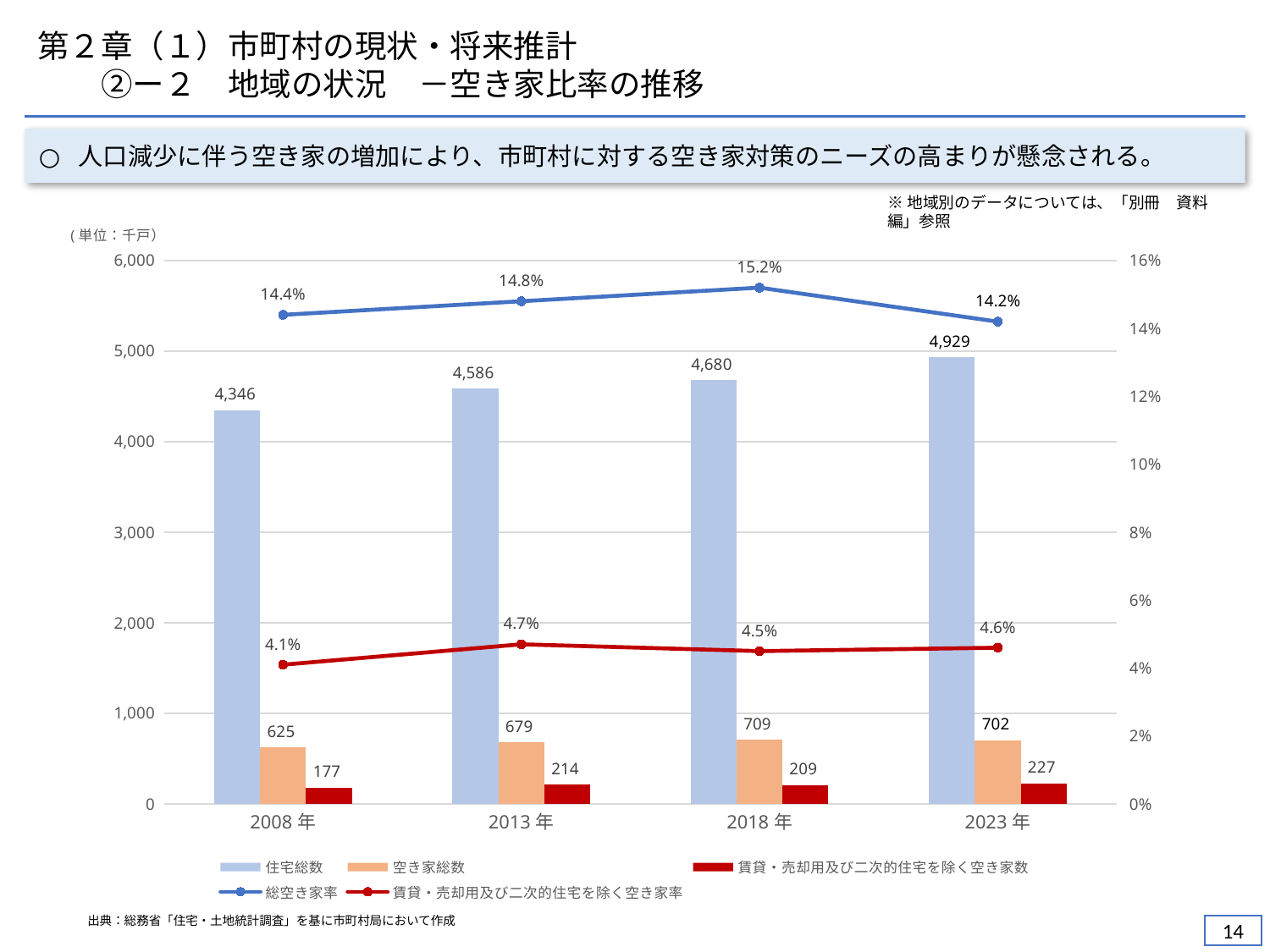
2023年と2008年の住宅総数の差はいくつですか？ 583 総空き家率が最も低い年はどれですか？ 2023年 グラフの左軸の単位は何ですか？ 千戸 グラフには何年分のデータが示されていますか？ 4 住宅総数は2008年から2023年にかけて増加していますか、減少していますか？ 増加 2013年と2018年では、賃貸・売却用及び二次的住宅を除く空き家数はどちらが多いですか？ 2013年 2008年の賃貸・売却用及び二次的住宅を除く空き家率は何％ですか？ 4.1% 2013年の賃貸・売却用及び二次的住宅を除く空き家数はいくつですか？ 214 2023年の住宅総数はいくつですか？ 4,929 空き家総数が最も多い年はどれですか？ 2018年 2018年の総空き家率は何％ですか？ 15.2% 凡例にはいくつの系列が示されていますか？ 5